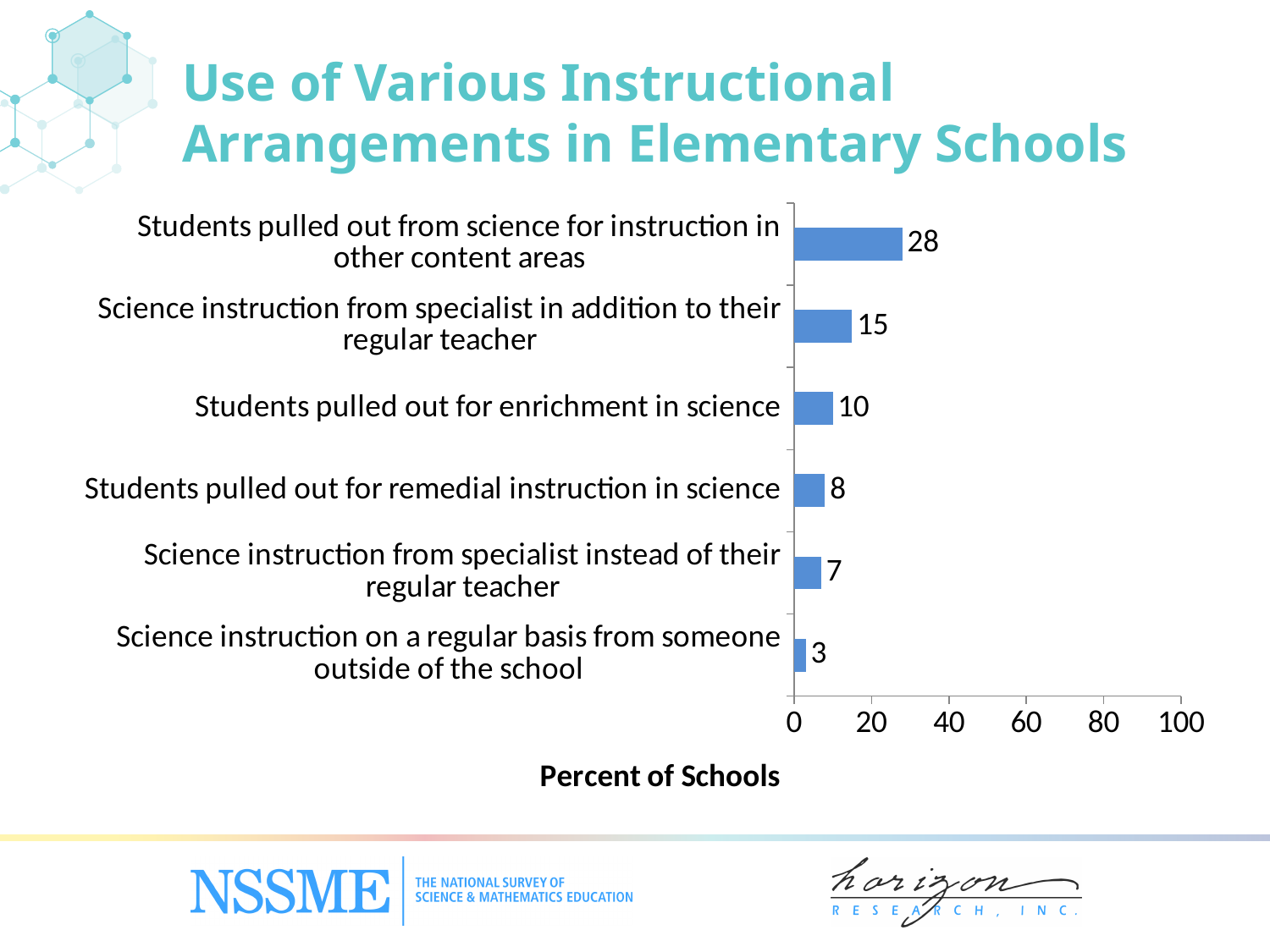
What percent of schools have students pulled out from science for instruction in other content areas? 28 Is the value for students pulled out from science for instruction in other content areas greater or less than 40? less What is the label of the horizontal axis? Percent of Schools What is the value for science instruction on a regular basis from someone outside of the school? 3 What is the difference between the value for students pulled out from science for instruction in other content areas and the value for science instruction from specialist in addition to their regular teacher? 13 How many instructional arrangements are shown in the chart? 6 What is the value for science instruction from specialist in addition to their regular teacher? 15 Which is larger: the value for students pulled out for remedial instruction in science or the value for science instruction from specialist instead of their regular teacher? Students pulled out for remedial instruction in science Which instructional arrangement has the lowest percent of schools? Science instruction on a regular basis from someone outside of the school What kind of chart is shown on the slide? Bar chart What percent of schools have students pulled out for enrichment in science? 10 Which instructional arrangement has the highest percent of schools? Students pulled out from science for instruction in other content areas